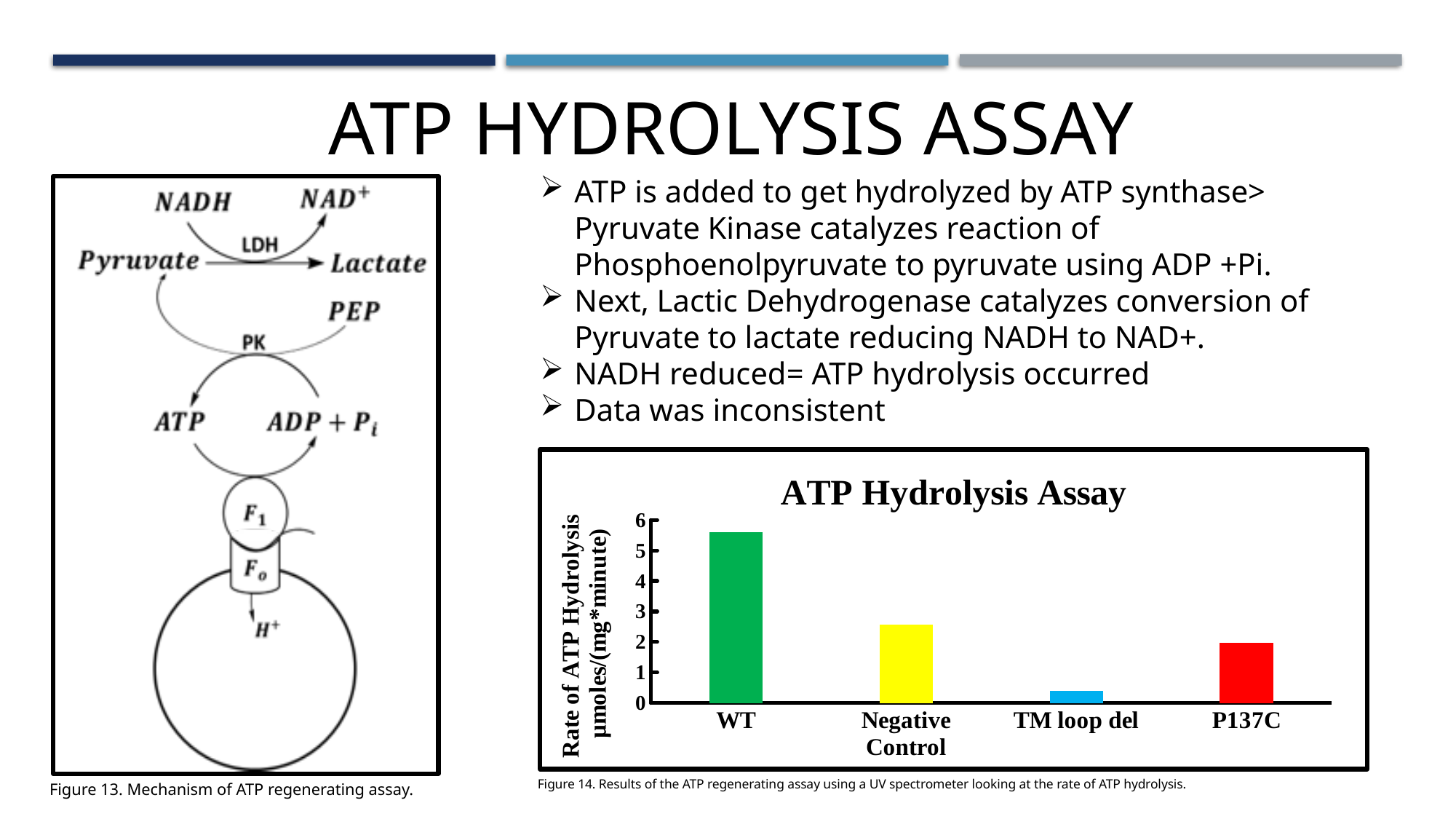
How many categories are plotted in the ATP Hydrolysis Assay chart? 4 In the ATP Hydrolysis Assay chart, which has a higher rate of ATP hydrolysis, WT or Negative Control? WT In the ATP Hydrolysis Assay chart, is the value for P137C greater or less than 1? greater Which category has the lowest rate of ATP hydrolysis in the ATP Hydrolysis Assay chart? TM loop del Which category has the highest rate of ATP hydrolysis in the ATP Hydrolysis Assay chart? WT What is the y-axis label of the ATP Hydrolysis Assay chart? Rate of ATP Hydrolysis µmoles/(mg*minute) What colour is the WT bar in the ATP Hydrolysis Assay chart? green In the ATP Hydrolysis Assay chart, is the value for Negative Control greater or less than 2? greater What kind of chart is shown in the ATP Hydrolysis Assay figure? bar chart In the ATP Hydrolysis Assay chart, is the value for TM loop del greater or less than 1? less In the ATP Hydrolysis Assay chart, which has a higher rate of ATP hydrolysis, Negative Control or P137C? Negative Control